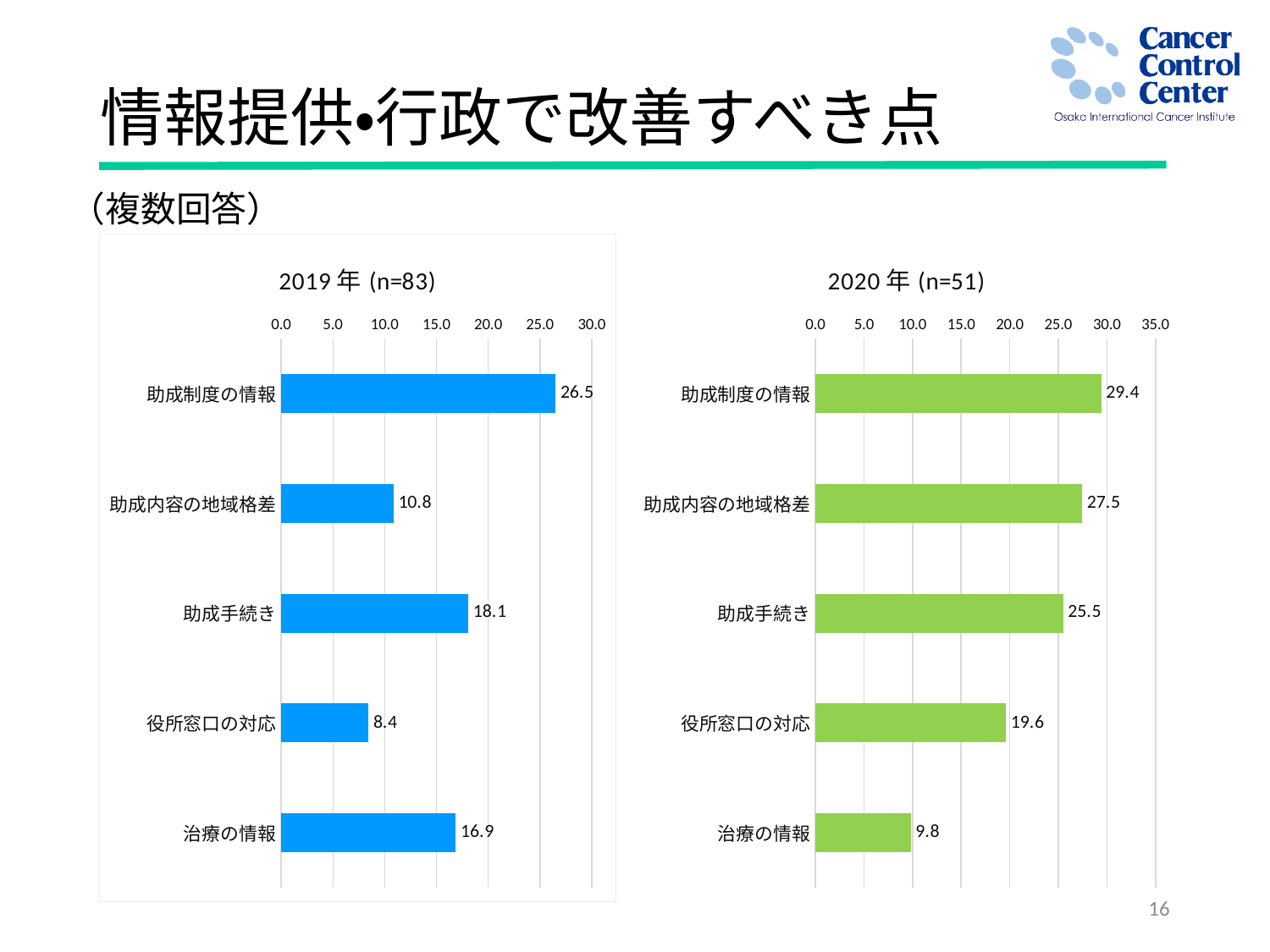
In the 2020年 (n=51) chart, what is the value for 役所窓口の対応? 19.6 How many categories are shown in the 2019年 (n=83) chart? 5 In the 2019年 (n=83) chart, what is the value for 助成制度の情報? 26.5 In the 2019年 (n=83) chart, what is the difference between 助成制度の情報 and 助成手続き? 8.4 What colour are the bars in the 2019年 (n=83) chart? blue What type of chart is the 2020年 (n=51) chart? bar chart In the 2020年 (n=51) chart, which category has the highest value? 助成制度の情報 In the 2019年 (n=83) chart, which is larger: 治療の情報 or 助成内容の地域格差? 治療の情報 In the 2019年 (n=83) chart, which category has the lowest value? 役所窓口の対応 In the 2020年 (n=51) chart, what is the difference between 助成制度の情報 and 治療の情報? 19.6 In the 2020年 (n=51) chart, is the value for 助成手続き greater or less than 20.0? greater In the 2020年 (n=51) chart, which category has the lowest value? 治療の情報